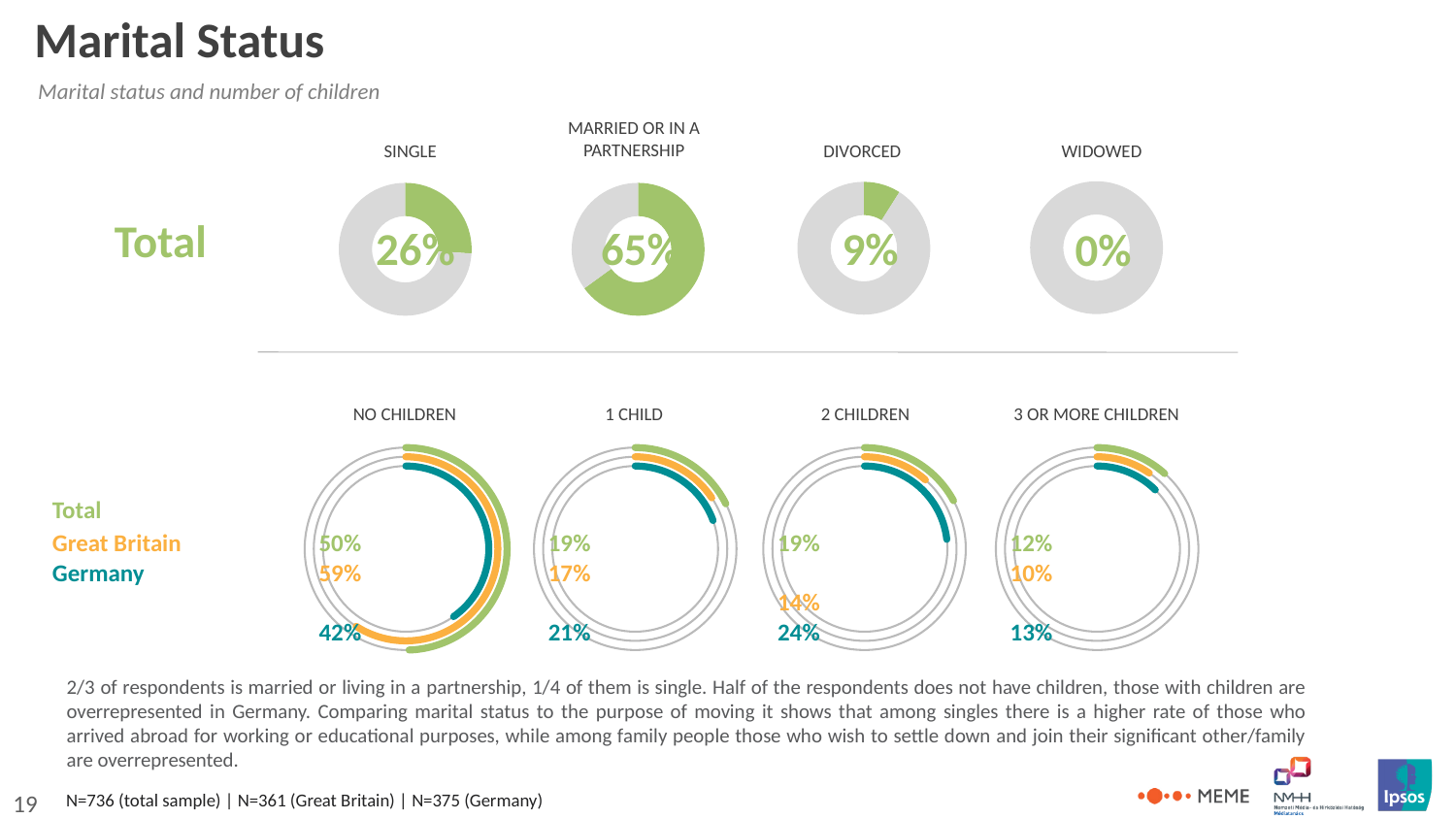
In the bottom row of number-of-children charts, which is larger for No children: Great Britain or Germany? Great Britain In the top row of marital status donut charts, which marital status has the highest Total share? Married or in a partnership In the bottom row of number-of-children charts, what is the difference between the Germany and Great Britain values for 2 children? 10% In the bottom row of number-of-children charts, what is the Great Britain value for 2 children? 14% How many series does the legend list for the bottom row of number-of-children charts? 3 In the top row of marital status donut charts, what is the Total share for Single? 26% In the top row of marital status donut charts, what is the difference between the Single share and the Divorced share? 17% In the top row of marital status donut charts, which marital status has the lowest Total share? Widowed In the bottom row of number-of-children charts, which colour represents Germany? Teal In the top row of marital status donut charts, what is the Total share for Married or in a partnership? 65% In the bottom row of number-of-children charts, what is the Germany value for No children? 42% How many marital status categories are shown in the top row of donut charts? 4